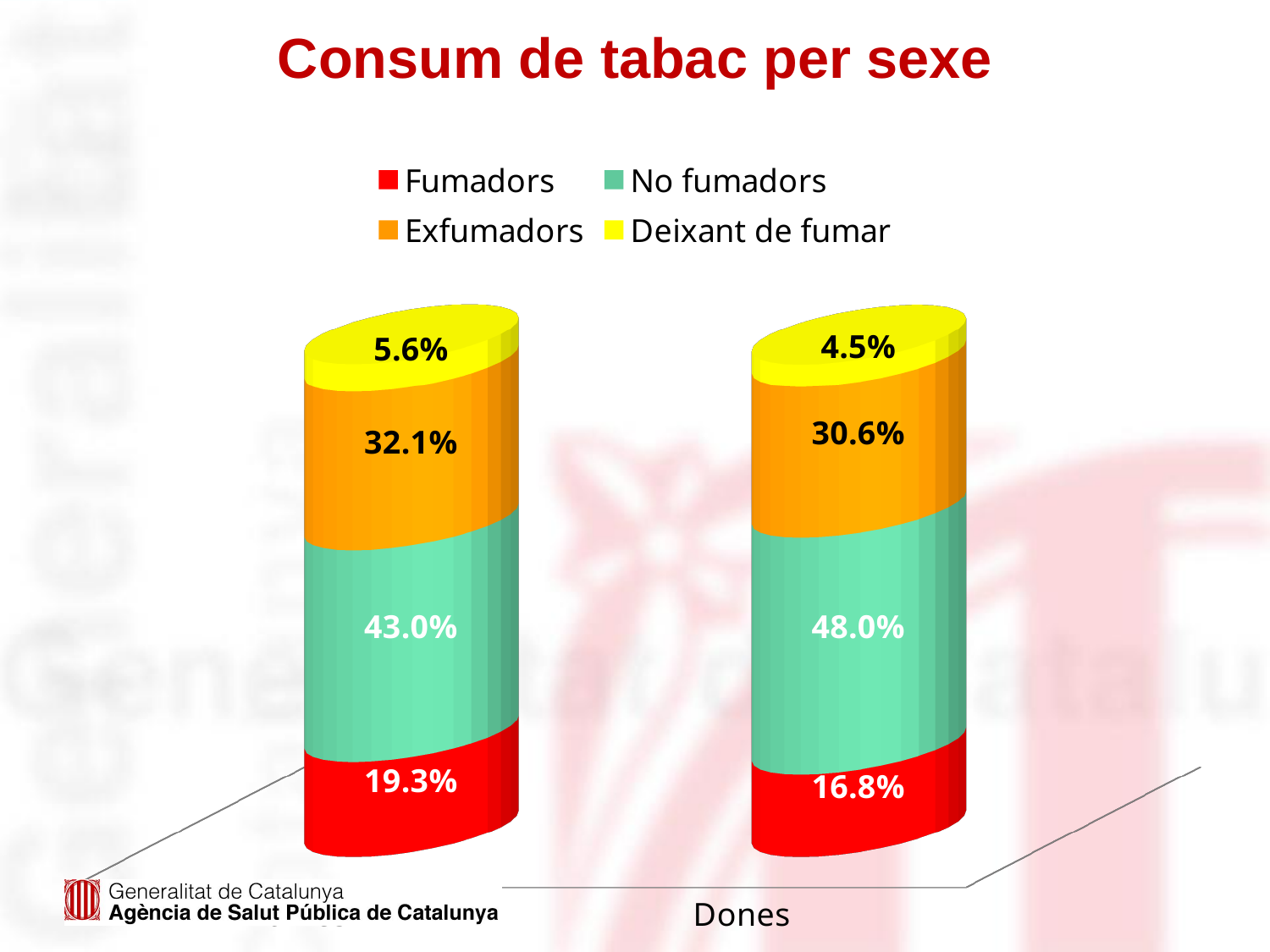
What is the value for No fumadors in the Dones bar? 48.0% What is the value for Exfumadors in the Dones bar? 30.6% What is the value for Fumadors in the left bar? 19.3% What is the value for Fumadors in the Dones bar? 16.8% Which bar has the larger Exfumadors value, the left bar or the Dones bar? The left bar How many series does the legend list? 4 Which series has the largest segment in the Dones bar? No fumadors Which series has the smallest segment in the left bar? Deixant de fumar What kind of chart is shown on the slide? Stacked bar chart What is the value for Deixant de fumar in the Dones bar? 4.5% How many bars are plotted in the chart? 2 What is the difference between the No fumadors value in the Dones bar and the No fumadors value in the left bar? 5.0%